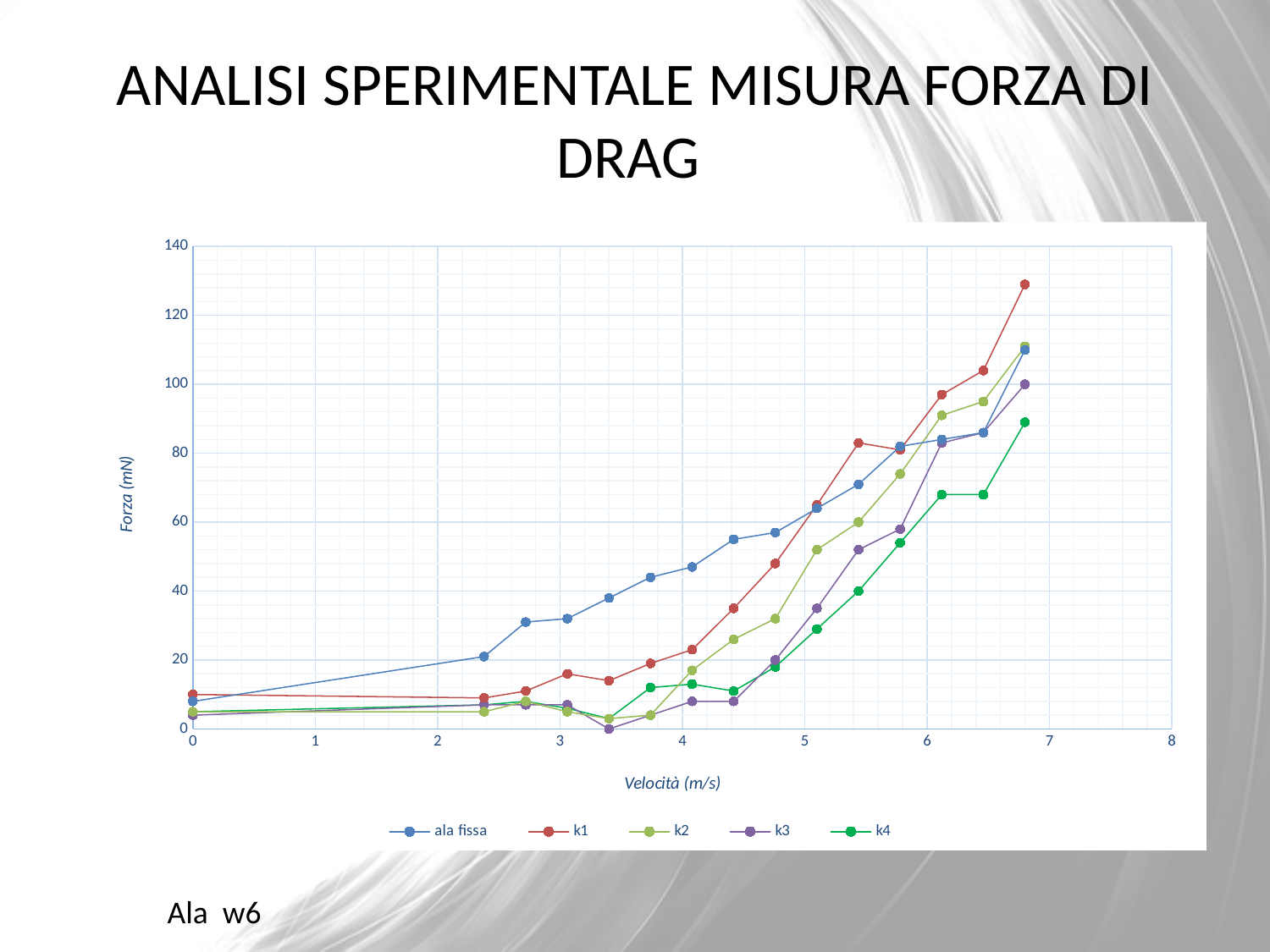
Which series has the lowest force value at the highest velocity plotted? k4 Is the value for k4 at the highest velocity plotted greater or less than 100? less What kind of chart is shown on the slide? line chart What is the label of the horizontal axis? Velocità (m/s) Is the value for ala fissa at the highest velocity plotted greater or less than 100? greater Which series reaches the highest force value at the highest velocity plotted? k1 How many series does the legend list? 5 At the highest velocity plotted, which series has the larger value, k1 or k4? k1 Do the values for k1 generally rise or fall as velocity increases? rise What is the label of the vertical axis? Forza (mN) At a velocity of about 3 m/s, which series has the larger value, ala fissa or k1? ala fissa Is the value for k1 at the highest velocity plotted greater or less than 120? greater